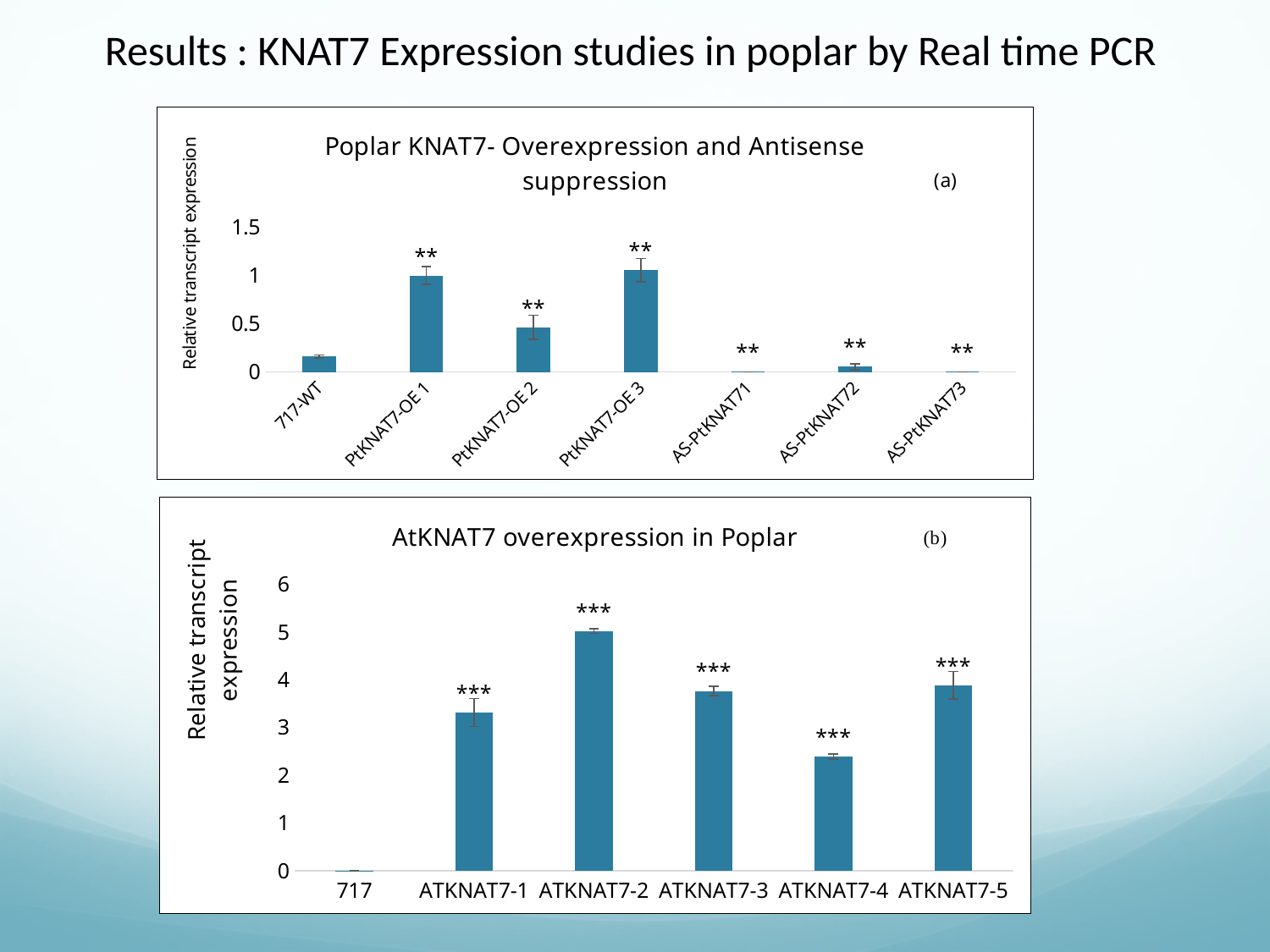
In the bottom chart (b), is the value for ATKNAT7-1 greater or less than 3? greater In the bottom chart (b), which has the larger value, ATKNAT7-3 or ATKNAT7-4? ATKNAT7-3 In the bottom chart "AtKNAT7 overexpression in Poplar", which category has the highest relative transcript expression? ATKNAT7-2 In the bottom chart (b), is the value for ATKNAT7-4 greater or less than 3? less What kind of chart is the top chart titled "Poplar KNAT7- Overexpression and Antisense suppression"? bar chart In the top chart (a), which has the larger value, PtKNAT7-OE 1 or PtKNAT7-OE 2? PtKNAT7-OE 1 In the top chart (a), is the value for 717-WT greater or less than 0.5? less How many categories are shown on the x axis of the bottom chart "AtKNAT7 overexpression in Poplar"? 6 In the bottom chart "AtKNAT7 overexpression in Poplar", which category has the lowest relative transcript expression? 717 What is the y-axis label of the bottom chart "AtKNAT7 overexpression in Poplar"? Relative transcript expression How many categories are shown on the x axis of the top chart (a)? 7